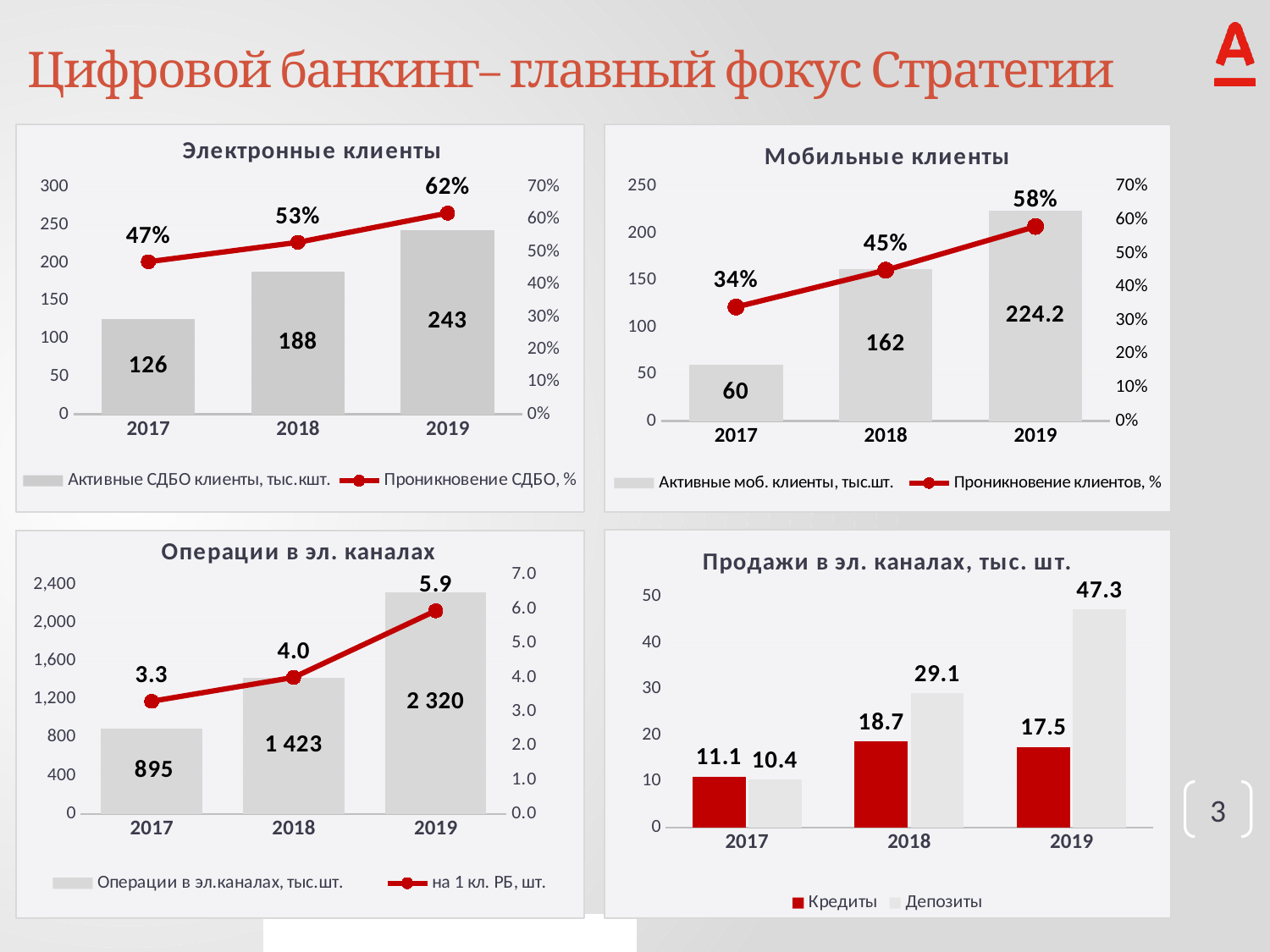
In the 'Электронные клиенты' chart, what is the penetration (Проникновение СДБО) in 2019? 62% In the 'Мобильные клиенты' chart, which year has the lowest number of active mobile clients? 2017 In the 'Операции в эл. каналах' chart, what is the value of operations per retail client (на 1 кл. РБ) in 2018? 4.0 In the 'Электронные клиенты' chart, what is the value of active СДБО clients in 2018? 188 In the 'Продажи в эл. каналах, тыс. шт.' chart, which is larger in 2018: Кредиты or Депозиты? Депозиты In the 'Мобильные клиенты' chart, what is the value of active mobile clients in 2019? 224.2 In the 'Продажи в эл. каналах, тыс. шт.' chart, how many series does the legend list? 2 In the 'Операции в эл. каналах' chart, do operations in electronic channels rise or fall from 2017 to 2019? rise In the 'Электронные клиенты' chart, by how much did active СДБО clients grow from 2017 to 2019? 117 In the 'Продажи в эл. каналах, тыс. шт.' chart, what is the value for Депозиты in 2019? 47.3 In the 'Мобильные клиенты' chart, what is the client penetration in 2017? 34% In the 'Операции в эл. каналах' chart, what is the number of operations in electronic channels in 2019? 2 320